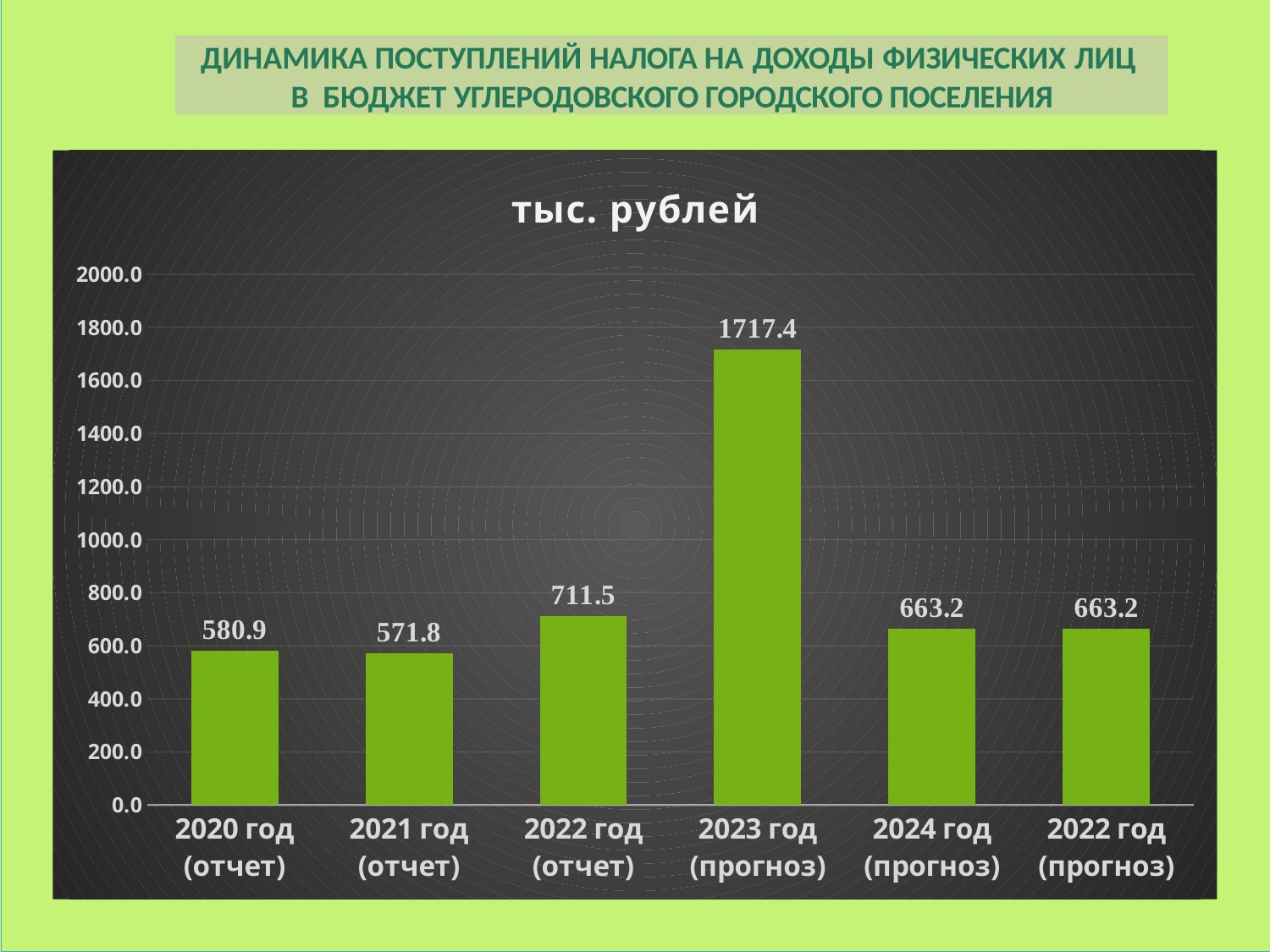
What is the value for 2020 год (отчет)? 580.9 What is the title shown above the chart's plot area? тыс. рублей Which is larger, the value for 2022 год (отчет) or the value for 2024 год (прогноз)? 2022 год (отчет) What is the value for 2021 год (отчет)? 571.8 What is the value for 2022 год (отчет)? 711.5 Which category has the highest value? 2023 год (прогноз) What is the difference between the values for 2023 год (прогноз) and 2022 год (отчет)? 1005.9 What kind of chart is shown on the slide? bar chart How many bars are shown in the chart? 6 What is the value for 2023 год (прогноз)? 1717.4 What is the value for 2024 год (прогноз)? 663.2 Which category has the lowest value? 2021 год (отчет)